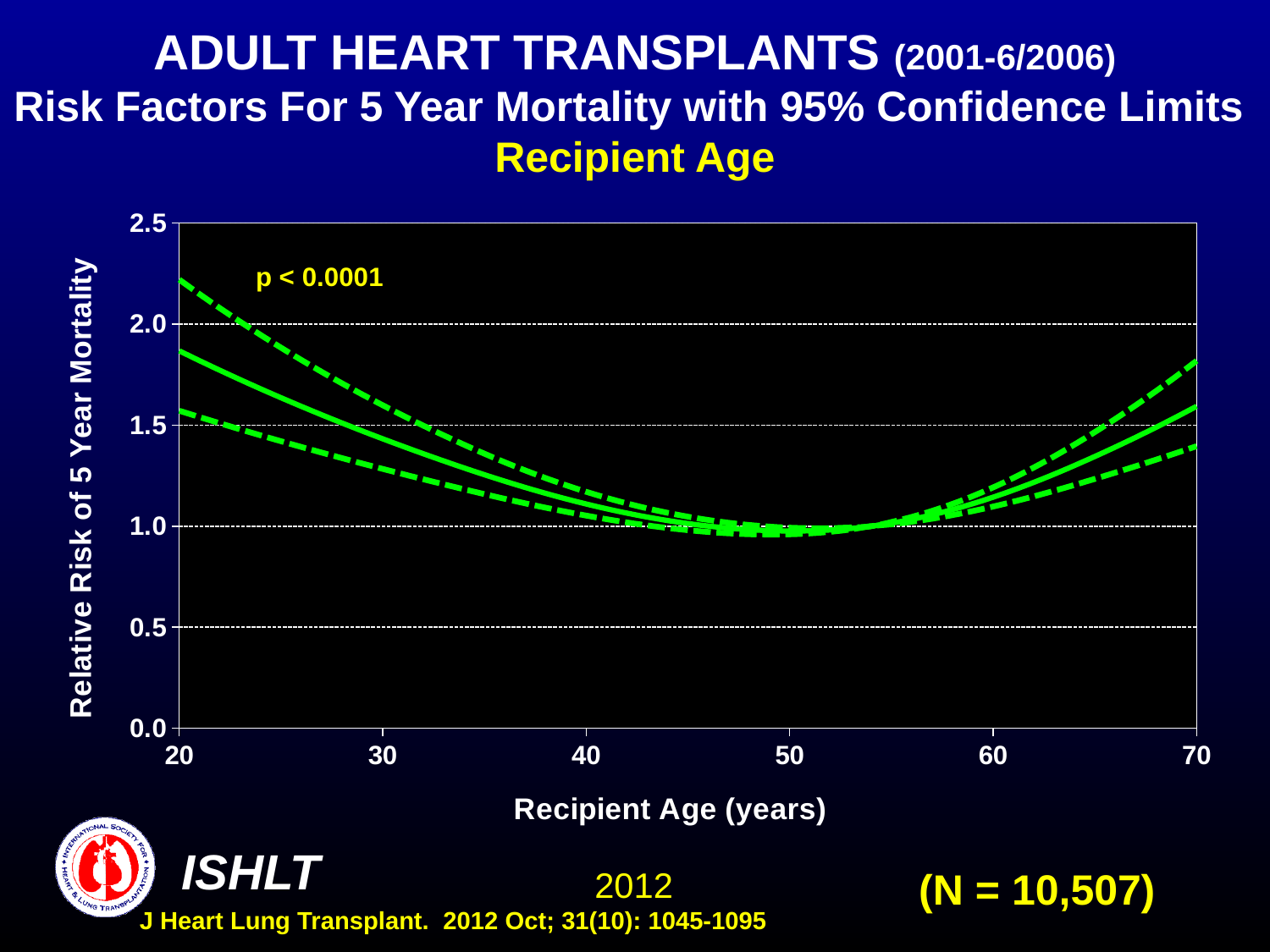
Is the upper 95% confidence limit at recipient age 20 greater or less than 2.0? greater What sample size (N) is shown on the slide? N = 10,507 How many lines are plotted on the chart? 3 Is the relative risk of 5 year mortality higher at recipient age 70 or at recipient age 50? age 70 Is the relative risk of 5 year mortality (solid line) at recipient age 50 greater or less than 1.5? less Is the relative risk of 5 year mortality (solid line) at recipient age 70 greater or less than 2.0? less What kind of chart is shown on the slide? line chart Does the relative risk of 5 year mortality rise or fall as recipient age increases from 20 to 50 years? fall What p-value is printed on the chart? p < 0.0001 Is the relative risk of 5 year mortality higher at recipient age 20 or at recipient age 50? age 20 Does the relative risk of 5 year mortality rise or fall as recipient age increases from 55 to 70 years? rise